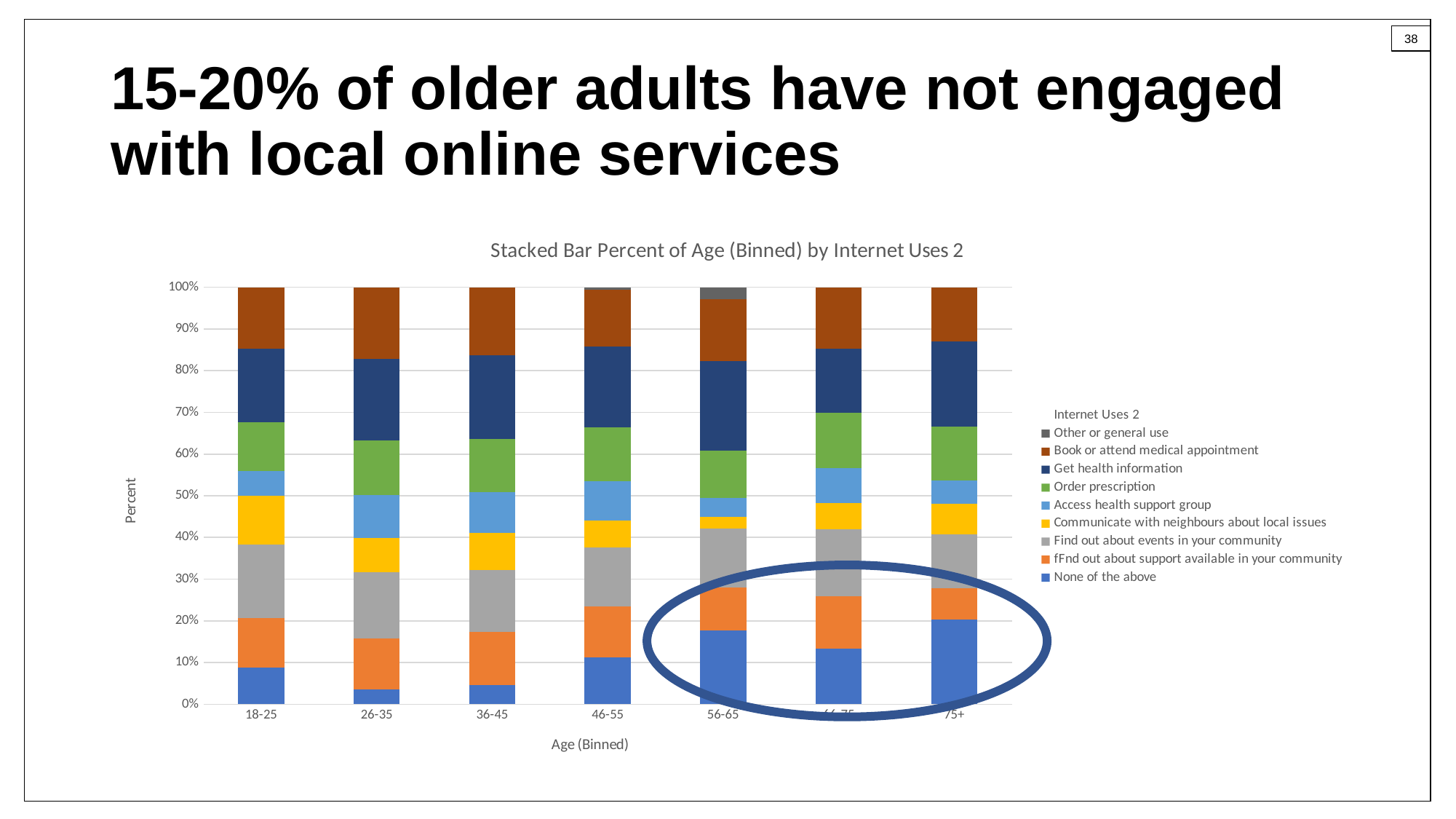
Is the 'None of the above' value for the 75+ age group greater or less than 10%? greater What is the title of the chart? Stacked Bar Percent of Age (Binned) by Internet Uses 2 What does each stacked bar in the chart total? 100% What is the label of the x axis of the chart? Age (Binned) Is the 'None of the above' value for the 26-35 age group greater or less than 10%? less Is the 'None of the above' value for the 56-65 age group greater or less than 10%? greater Which age group has a larger 'None of the above' segment, 56-65 or 36-45? 56-65 Which age group has a larger 'None of the above' segment, 75+ or 26-35? 75+ How many age categories are shown on the x axis of the chart? 7 How many series does the chart's legend list? 9 Which age group has the largest 'None of the above' segment? 75+ What type of chart is shown on the slide? Stacked bar chart